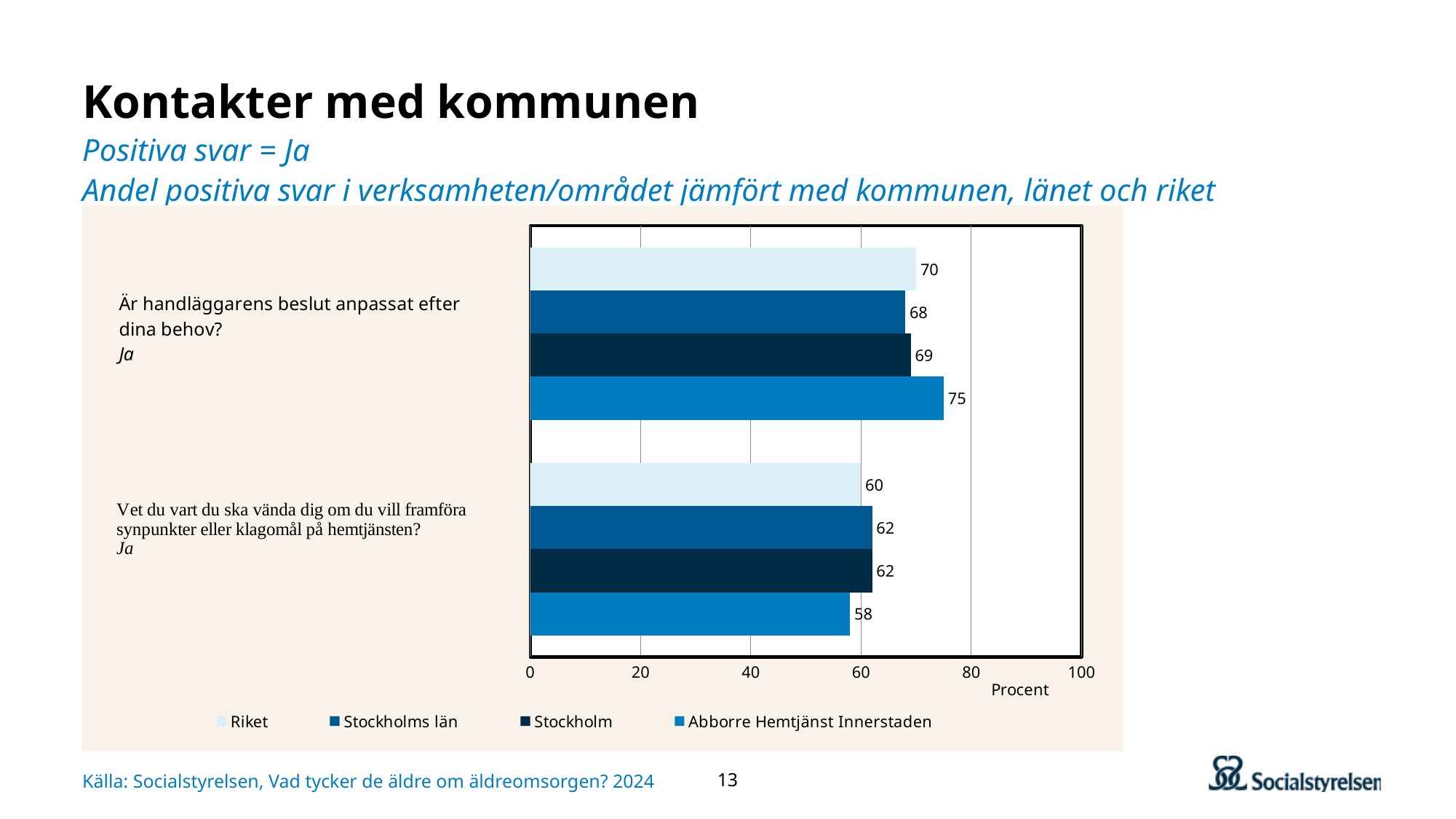
What is the difference between the Abborre Hemtjänst Innerstaden value and the Riket value for the question "Är handläggarens beslut anpassat efter dina behov?"? 5 What unit label is shown on the horizontal axis of the chart? Procent What value is shown for Riket on the question "Vet du vart du ska vända dig om du vill framföra synpunkter eller klagomål på hemtjänsten?"? 60 How many questions (categories) are shown on the chart? 2 Which series has the highest value for the question "Är handläggarens beslut anpassat efter dina behov?"? Abborre Hemtjänst Innerstaden Which series has the lowest value for the question "Vet du vart du ska vända dig om du vill framföra synpunkter eller klagomål på hemtjänsten?"? Abborre Hemtjänst Innerstaden What value is shown for Stockholms län on the question "Är handläggarens beslut anpassat efter dina behov?"? 68 What value is shown for Abborre Hemtjänst Innerstaden on the question "Är handläggarens beslut anpassat efter dina behov?"? 75 How many series does the legend list? 4 Is the value for Abborre Hemtjänst Innerstaden on the question "Vet du vart du ska vända dig om du vill framföra synpunkter eller klagomål på hemtjänsten?" greater or less than 60? less What kind of chart is shown on the slide? Bar chart For the question "Vet du vart du ska vända dig om du vill framföra synpunkter eller klagomål på hemtjänsten?", which is larger: the value for Stockholm or the value for Abborre Hemtjänst Innerstaden? Stockholm